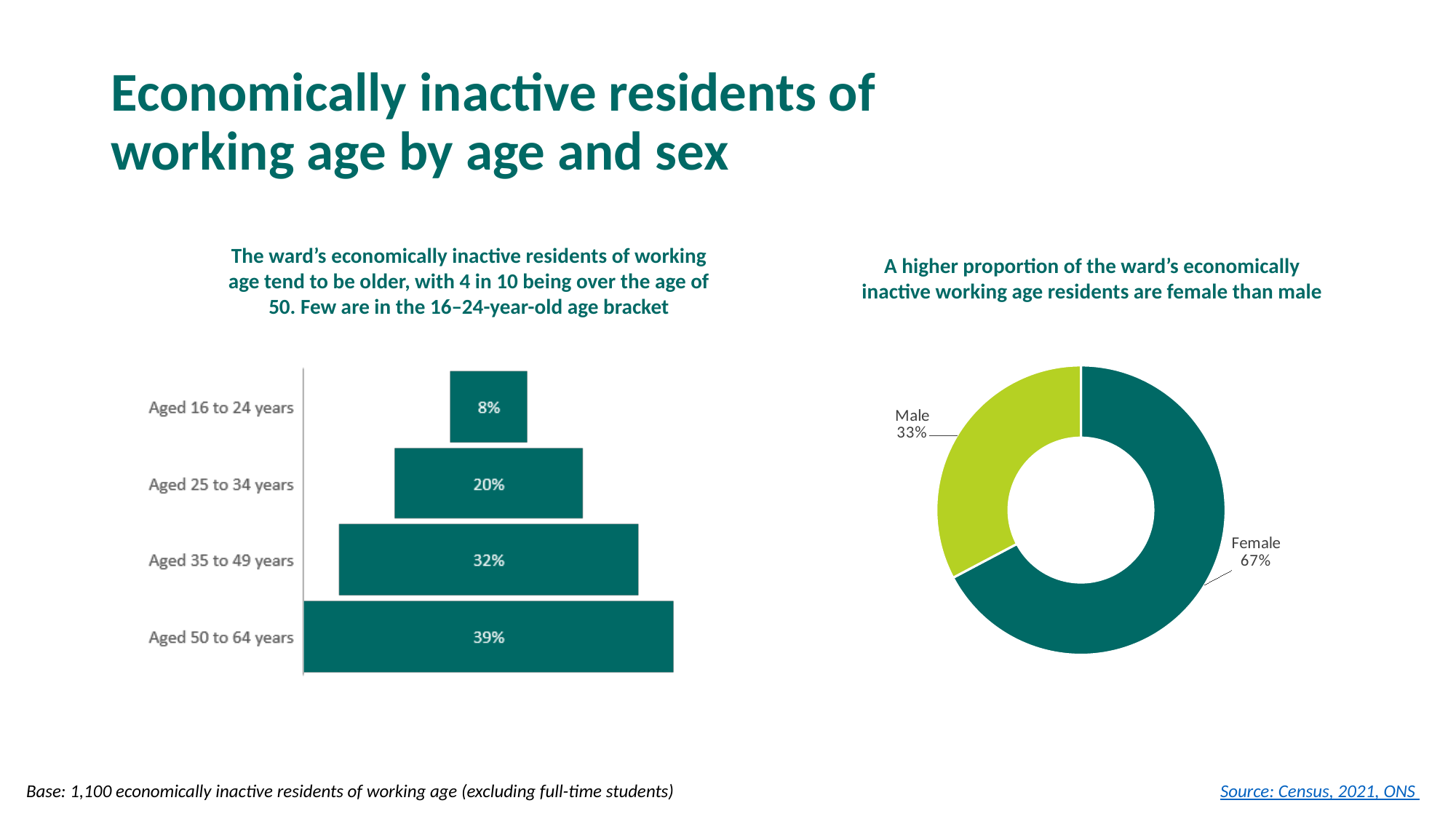
In the right chart (by sex), what share of economically inactive residents are male? 33% In the right chart (by sex), what is the difference in percentage points between the female and male shares? 34 In the left chart (age bands), which is larger: the value for aged 25 to 34 years or aged 35 to 49 years? Aged 35 to 49 years In the left chart (age bands), which age group has the highest percentage? Aged 50 to 64 years What kind of chart is the right chart showing the split by sex? Doughnut (pie) chart What kind of chart is the left chart showing age bands? Bar chart How many age categories are shown in the left chart? 4 In the left chart (age bands), what percentage of economically inactive residents are aged 16 to 24 years? 8% In the right chart (by sex), what share of economically inactive residents are female? 67% In the left chart (age bands), what is the difference in percentage points between the 50 to 64 years group and the 25 to 34 years group? 19 In the left chart (age bands), which age group has the lowest percentage? Aged 16 to 24 years In the left chart (age bands), what percentage of economically inactive residents are aged 35 to 49 years? 32%